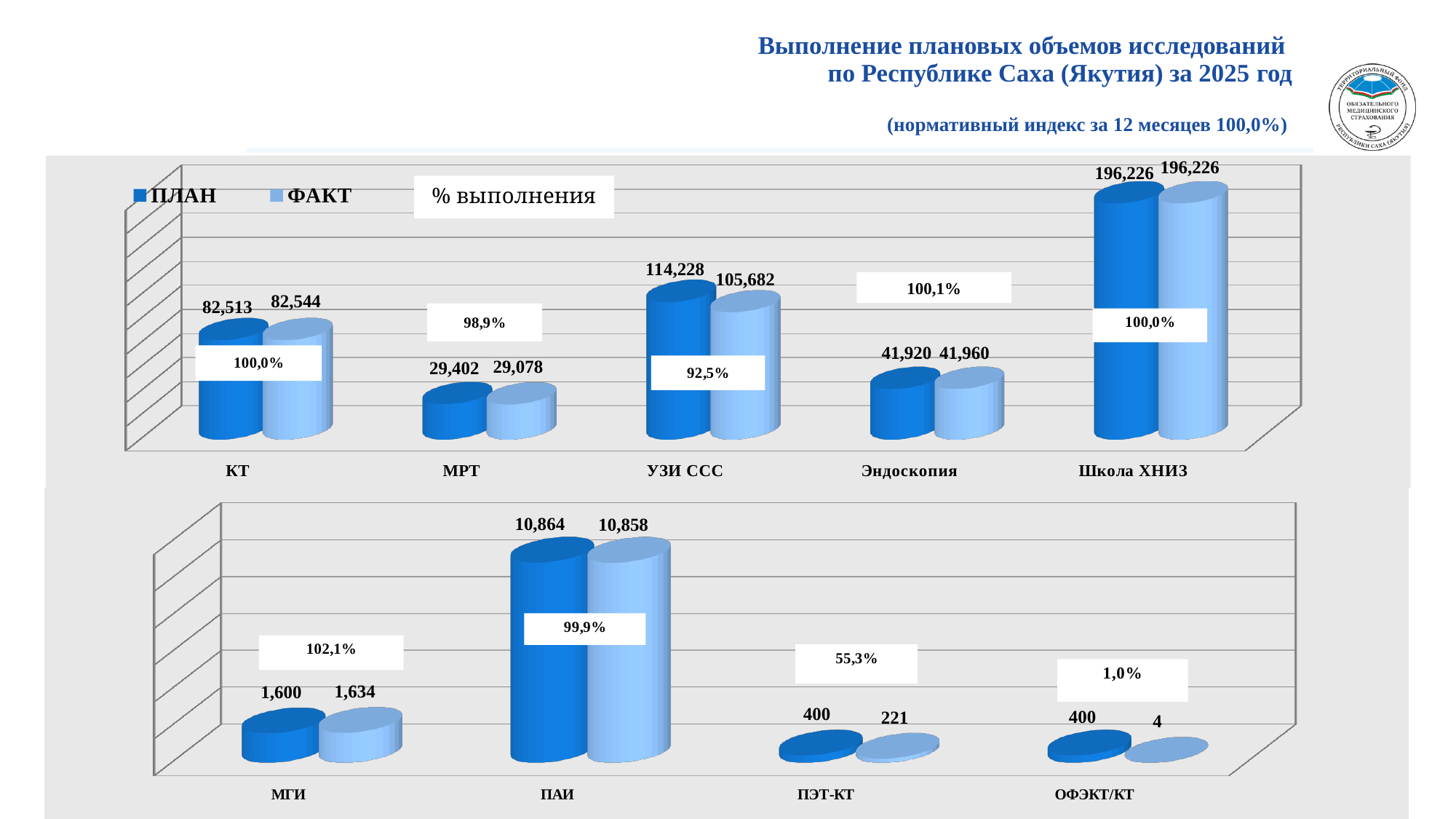
In the top chart, what is the difference between the ПЛАН and ФАКТ values for УЗИ ССС? 8,546 In the top chart, what is the ФАКТ value for МРТ? 29,078 In the bottom chart, what percentage of completion (% выполнения) is shown for ПЭТ-КТ? 55,3% In the bottom chart, what is the ПЛАН value for МГИ? 1,600 How many categories are shown in the bottom chart? 4 In the bottom chart, what is the ФАКТ value for ПЭТ-КТ? 221 How many series does the legend of the top chart list? 2 In the top chart, which category has the highest ПЛАН value? Школа ХНИЗ In the bottom chart, which category has the lowest ФАКТ value? ОФЭКТ/КТ In the bottom chart, which is larger for МГИ: the ПЛАН value or the ФАКТ value? ФАКТ In the top chart, what is the ПЛАН value for УЗИ ССС? 114,228 What type of chart is the top chart? Bar chart